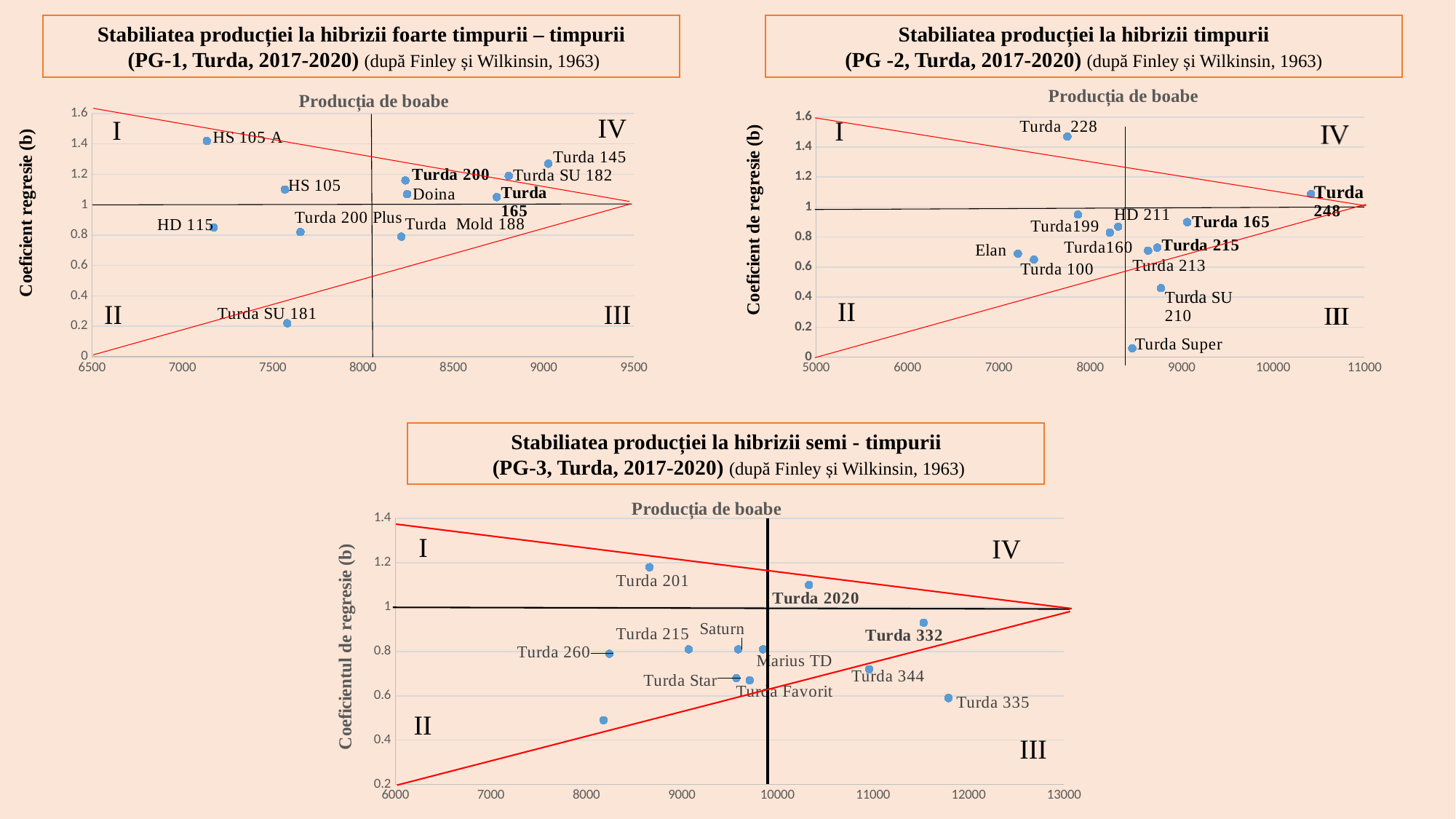
In the PG-2 chart (top right), which has the higher regression coefficient, Turda SU 210 or Turda 213? Turda 213 In the PG-2 chart (top right), which hybrid has the highest regression coefficient (b)? Turda 228 In the PG-2 chart (top right), which hybrid has the lowest regression coefficient (b)? Turda Super In the PG-1 chart (top left), which hybrid has the highest regression coefficient (b)? HS 105 A In the PG-1 chart (top left), is the regression coefficient for Turda SU 181 greater or less than 0.4? less In the PG-1 chart (top left), which has the higher regression coefficient, HS 105 A or Turda 145? HS 105 A What is the x-axis title of the PG-3 chart (bottom)? Producția de boabe What kind of chart is the PG-1 chart (top left)? scatter chart In the PG-1 chart (top left), how many hybrids are plotted? 11 In the PG-2 chart (top right), is the grain production (Producția de boabe) for Turda 248 greater or less than 10000? greater In the PG-3 chart (bottom), is the regression coefficient for Turda 2020 greater or less than 1? greater In the PG-1 chart (top left), which hybrid has the lowest regression coefficient (b)? Turda SU 181